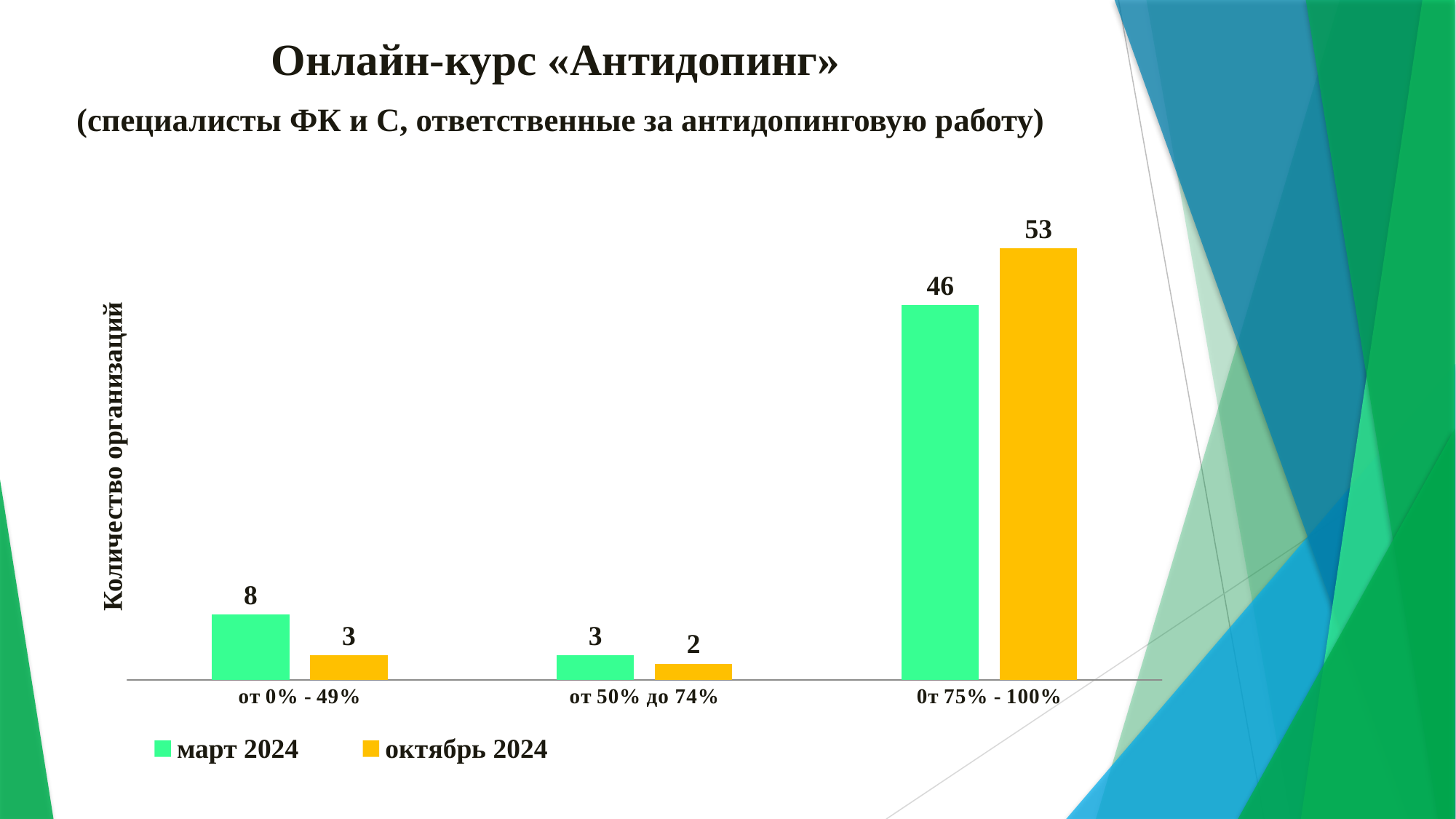
What is the value for октябрь 2024 in the category от 75% - 100%? 53 What kind of chart is shown on the slide? bar chart What is the label of the vertical axis? Количество организаций What is the value for октябрь 2024 in the category от 50% до 74%? 2 Which category has the lowest value for октябрь 2024? от 50% до 74% How many categories are shown on the x axis? 3 What is the value for март 2024 in the category от 50% до 74%? 3 In the category от 0% - 49%, which series has the larger value, март 2024 or октябрь 2024? март 2024 What is the difference between октябрь 2024 and март 2024 in the category от 75% - 100%? 7 How many series does the legend list? 2 Which category has the highest value for март 2024? от 75% - 100% What is the value for март 2024 in the category от 0% - 49%? 8